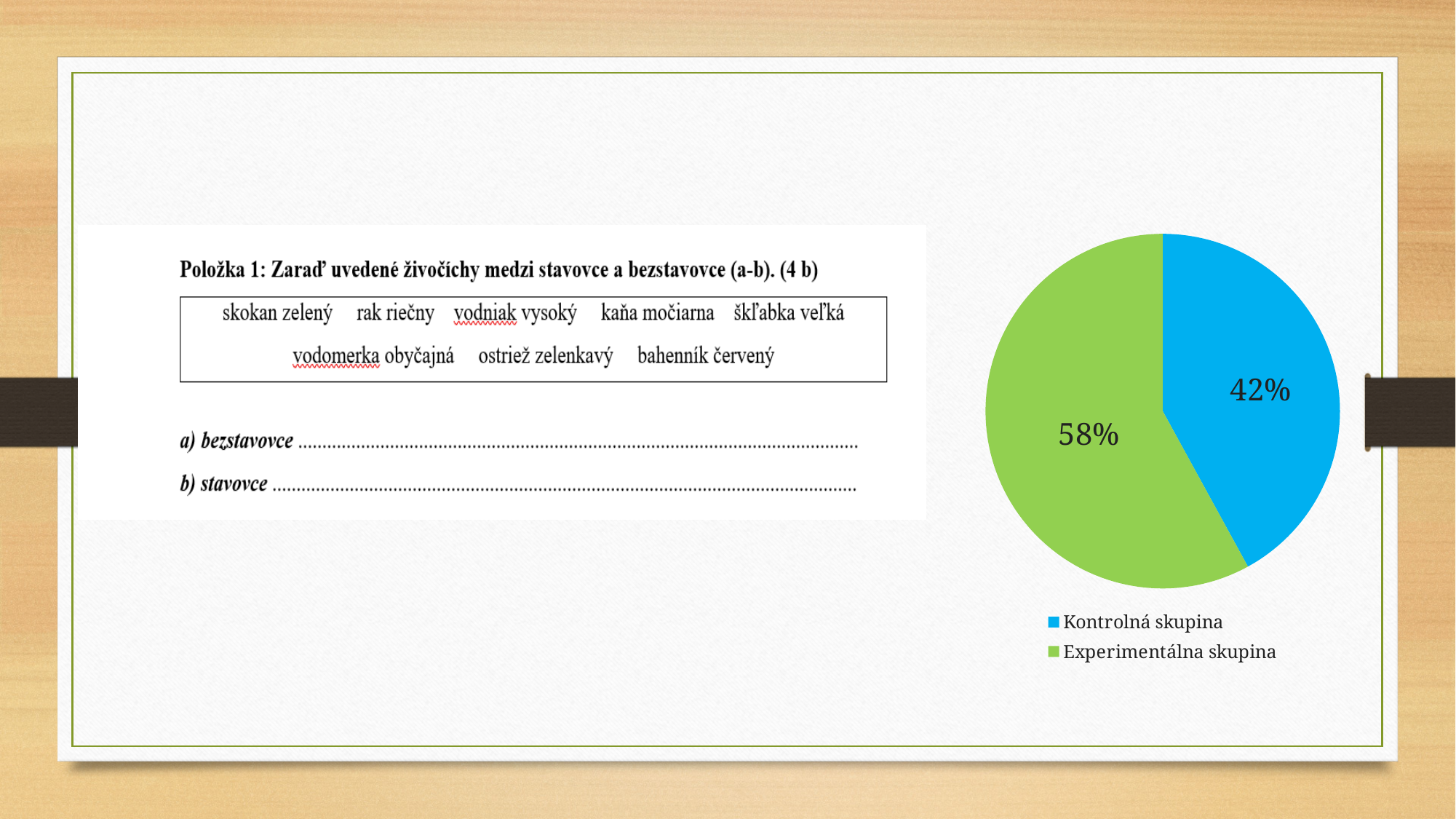
What kind of chart is shown on the slide? pie chart What is the difference between the Experimentálna skupina and Kontrolná skupina shares? 16% What share of the pie does Experimentálna skupina take? 58% How many slices does the pie chart have? 2 What is the value for Kontrolná skupina? 42% Which group has the largest slice of the pie? Experimentálna skupina How many entries does the legend list? 2 What colour is the slice for Experimentálna skupina? green What is the value for Experimentálna skupina? 58% Which is larger, the share for Kontrolná skupina or for Experimentálna skupina? Experimentálna skupina What colour is the slice for Kontrolná skupina? blue Which group has the smallest slice of the pie? Kontrolná skupina